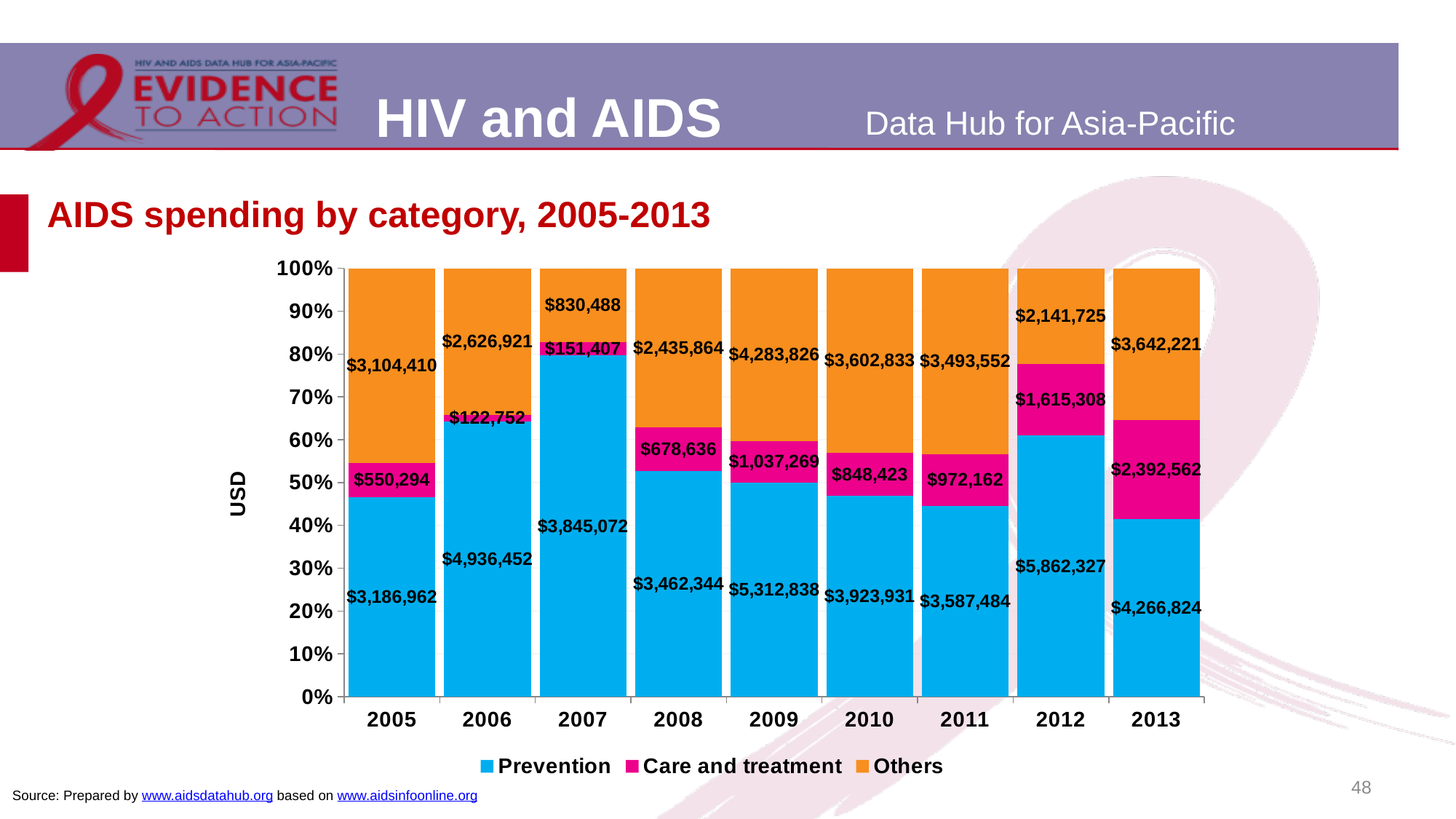
What was the Prevention spending in 2012? $5,862,327 What is the difference between Prevention spending in 2012 and in 2013? $1,595,503 Which year had the highest Prevention spending? 2012 What was the Care and treatment spending in 2006? $122,752 What is the total AIDS spending across all three categories in 2005? $6,841,666 Which was larger in 2013: Care and treatment spending or Others spending? Others How many years are shown on the x axis? 9 What was the Others spending in 2009? $4,283,826 Is the Prevention share of spending in 2006 greater or less than 60%? greater Which year had the lowest Care and treatment spending? 2006 Which year had the lowest Others spending? 2007 How many series does the legend list? 3